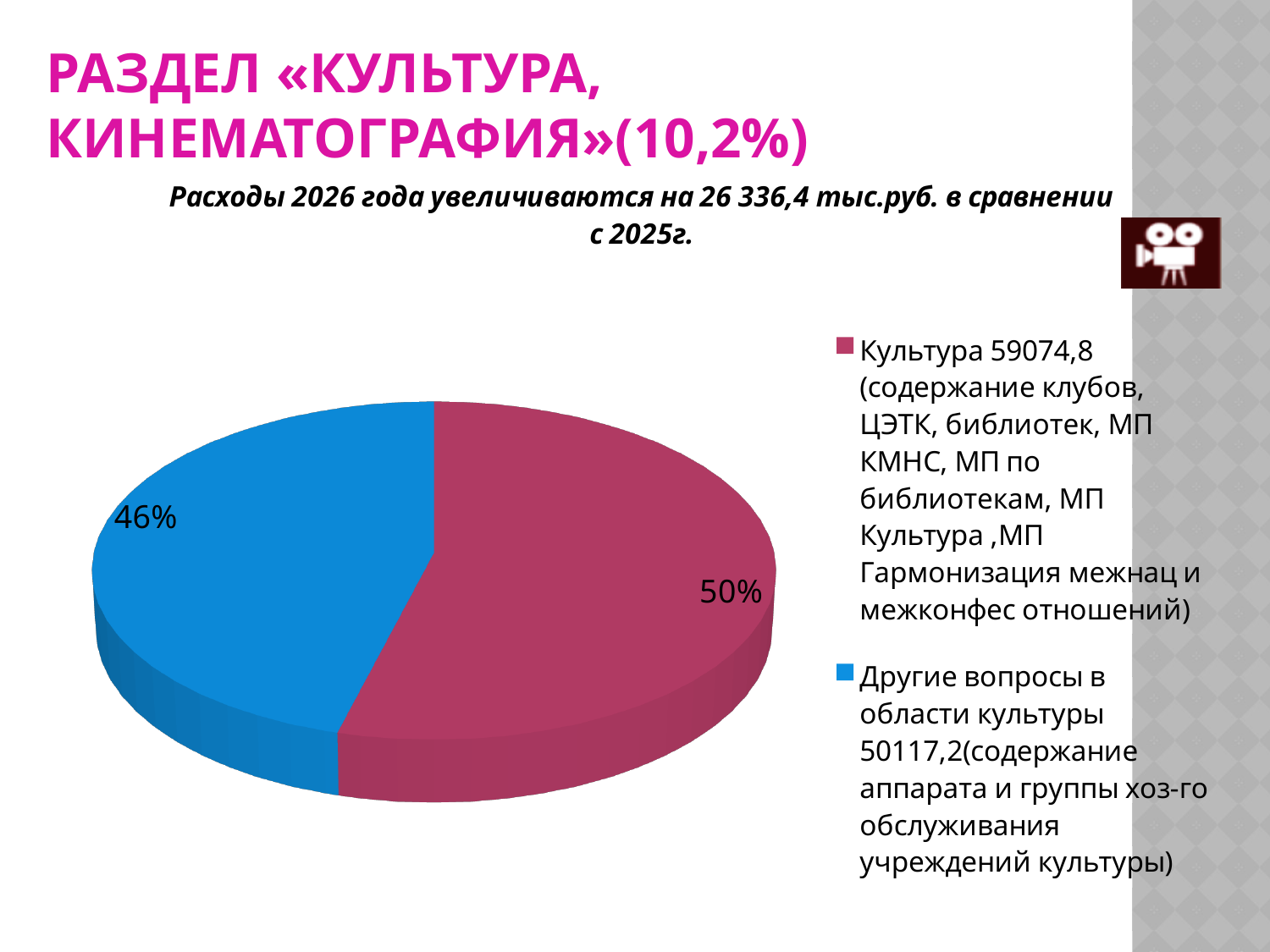
What kind of chart is shown on the slide? Pie chart What colour is the slice for "Другие вопросы в области культуры"? Blue What amount is given in the legend for "Культура"? 59074,8 Which is larger: the share for "Культура" or the share for "Другие вопросы в области культуры"? Культура How many slices does the pie chart have? 2 Which slice of the pie chart is the smallest? Другие вопросы в области культуры What share of the pie is labelled for the slice "Культура"? 50% Which slice of the pie chart is the largest? Культура By how many percentage points does the "Культура" share exceed the "Другие вопросы в области культуры" share? 4 What amount is given in the legend for "Другие вопросы в области культуры"? 50117,2 What share of the pie is labelled for the slice "Другие вопросы в области культуры"? 46% How many entries does the legend of the pie chart list? 2